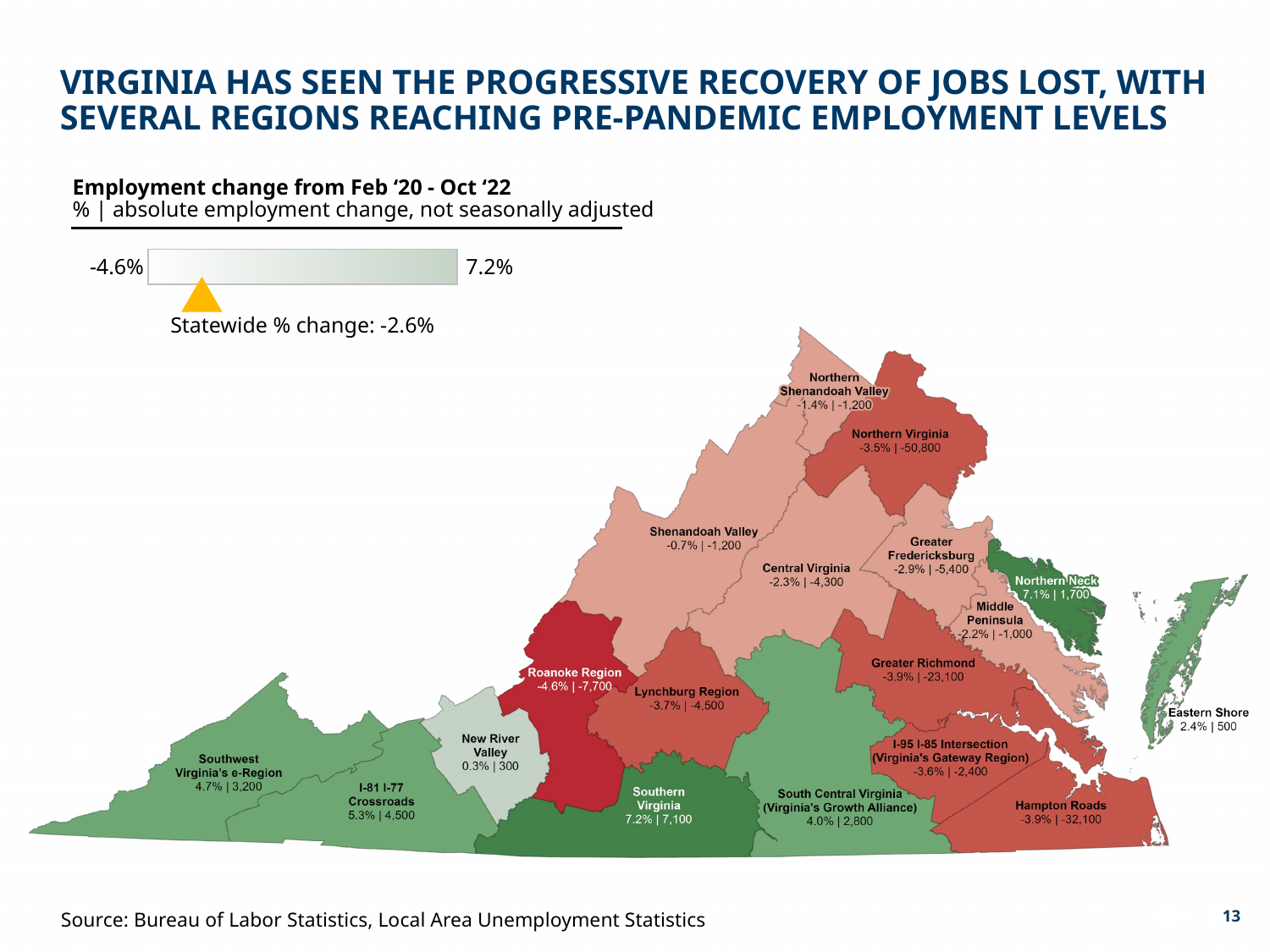
Which region has the lowest percentage employment change on the map? Roanoke Region What is the absolute employment change shown for Hampton Roads? -32,100 What are the minimum and maximum values shown on the color scale legend? -4.6% and 7.2% What is the statewide percentage employment change shown on the slide? -2.6% Which region has a higher percentage employment change, Northern Neck or Southwest Virginia's e-Region? Northern Neck What is the percentage employment change shown for Northern Virginia? -3.5% What kind of chart is shown on the slide? Map (choropleth) Which region has the highest percentage employment change on the map? Southern Virginia What is the difference in absolute employment change between Northern Virginia and Greater Richmond? 27,700 How many regions are labeled with values on the map? 18 What is the percentage employment change shown for the I-81 I-77 Crossroads region? 5.3% What is the absolute employment change shown for the Eastern Shore? 500